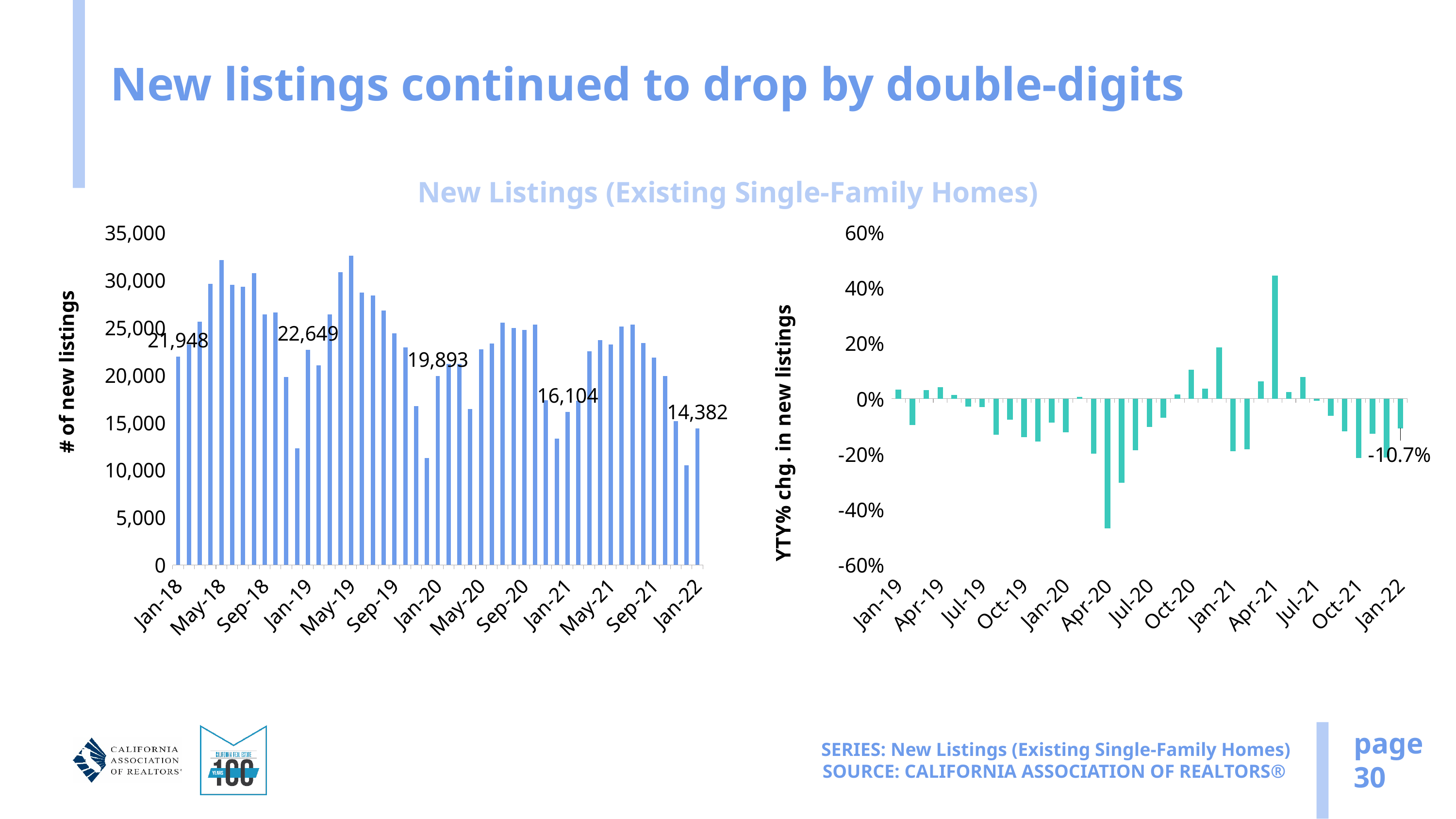
On the left chart (# of new listings), what is the difference between the Jan-21 and Jan-22 values? 1,722 What is the title shown above the charts on the slide? New Listings (Existing Single-Family Homes) What kind of chart is the left chart (# of new listings)? bar chart On the left chart (# of new listings), what is the value for Jan-18? 21,948 On the left chart (# of new listings), what is the difference between the Jan-18 and Jan-22 values? 7,566 On the left chart (# of new listings), do the labelled January values rise or fall from Jan-18 to Jan-22? fall On the left chart (# of new listings), what is the value for Jan-22? 14,382 On the left chart (# of new listings), which is larger, the value for Jan-19 or the value for Jan-20? Jan-19 On the right chart (YTY% chg. in new listings), what is the value for Jan-22? -10.7% On the left chart (# of new listings), what is the value for Jan-21? 16,104 On the right chart (YTY% chg. in new listings), is the value for Apr-20 greater or less than -40%? less On the right chart (YTY% chg. in new listings), is the value for Apr-21 greater or less than 20%? greater